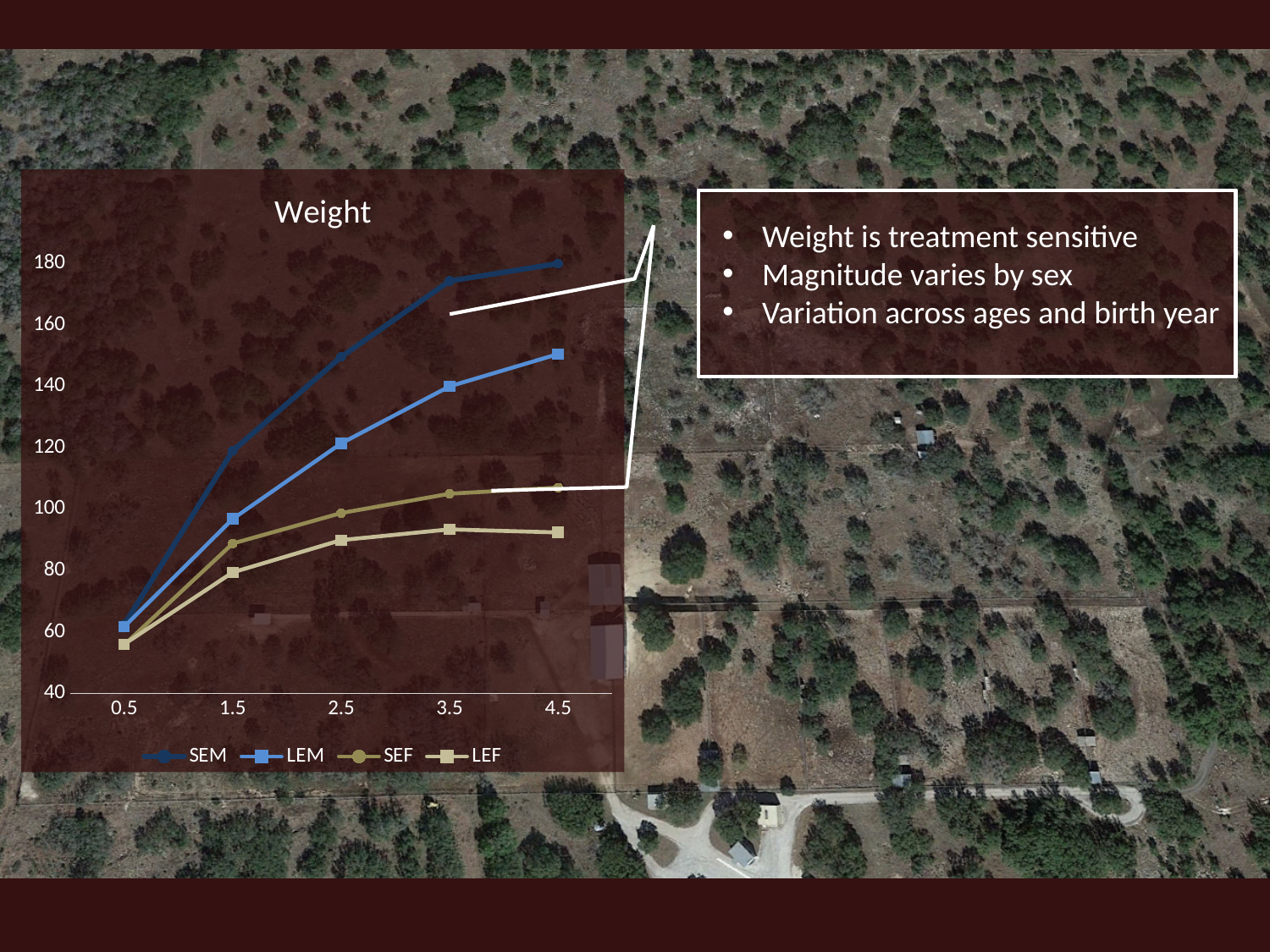
Which series has the lowest value at 4.5? LEF Which series has the highest value at 4.5? SEM Is the value for SEM at 2.5 greater or less than 140? greater What kind of chart is shown on the slide? line chart Do the values for the SEM series rise or fall from 0.5 to 4.5? rise Is the value for SEM at 4.5 greater or less than 160? greater At 3.5, which series has the larger value, SEM or LEM? SEM Is the value for LEF at 4.5 greater or less than 100? less How many series does the chart's legend list? 4 What is the title of the chart? Weight How many points are plotted along the x axis for each series? 5